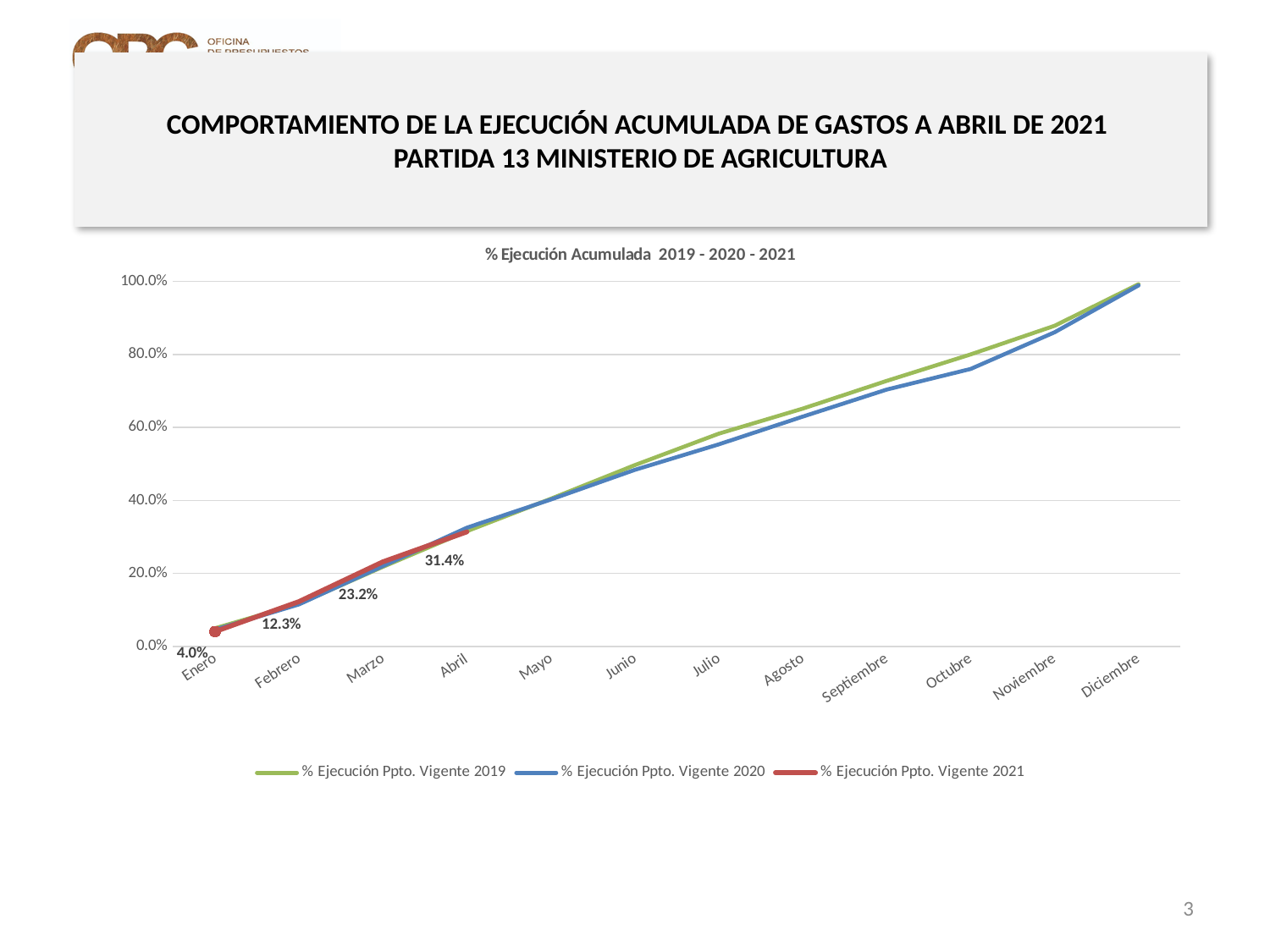
What is the value of % Ejecución Ppto. Vigente 2021 for Febrero? 12.3% What kind of chart is shown on the slide? Line chart How many months are shown on the x axis of the chart? 12 Is the value of % Ejecución Ppto. Vigente 2019 for Octubre greater or less than 60.0%? greater How many series does the legend list? 3 Do the values of % Ejecución Ppto. Vigente 2019 rise or fall from Enero to Diciembre? Rise What is the value of % Ejecución Ppto. Vigente 2021 for Marzo? 23.2% By how many percentage points did % Ejecución Ppto. Vigente 2021 increase from Febrero to Marzo? 10.9 What is the title of the chart? % Ejecución Acumulada 2019 - 2020 - 2021 By how many percentage points did % Ejecución Ppto. Vigente 2021 increase from Marzo to Abril? 8.2 What is the value of % Ejecución Ppto. Vigente 2021 for Enero? 4.0% What is the value of % Ejecución Ppto. Vigente 2021 for Abril? 31.4%